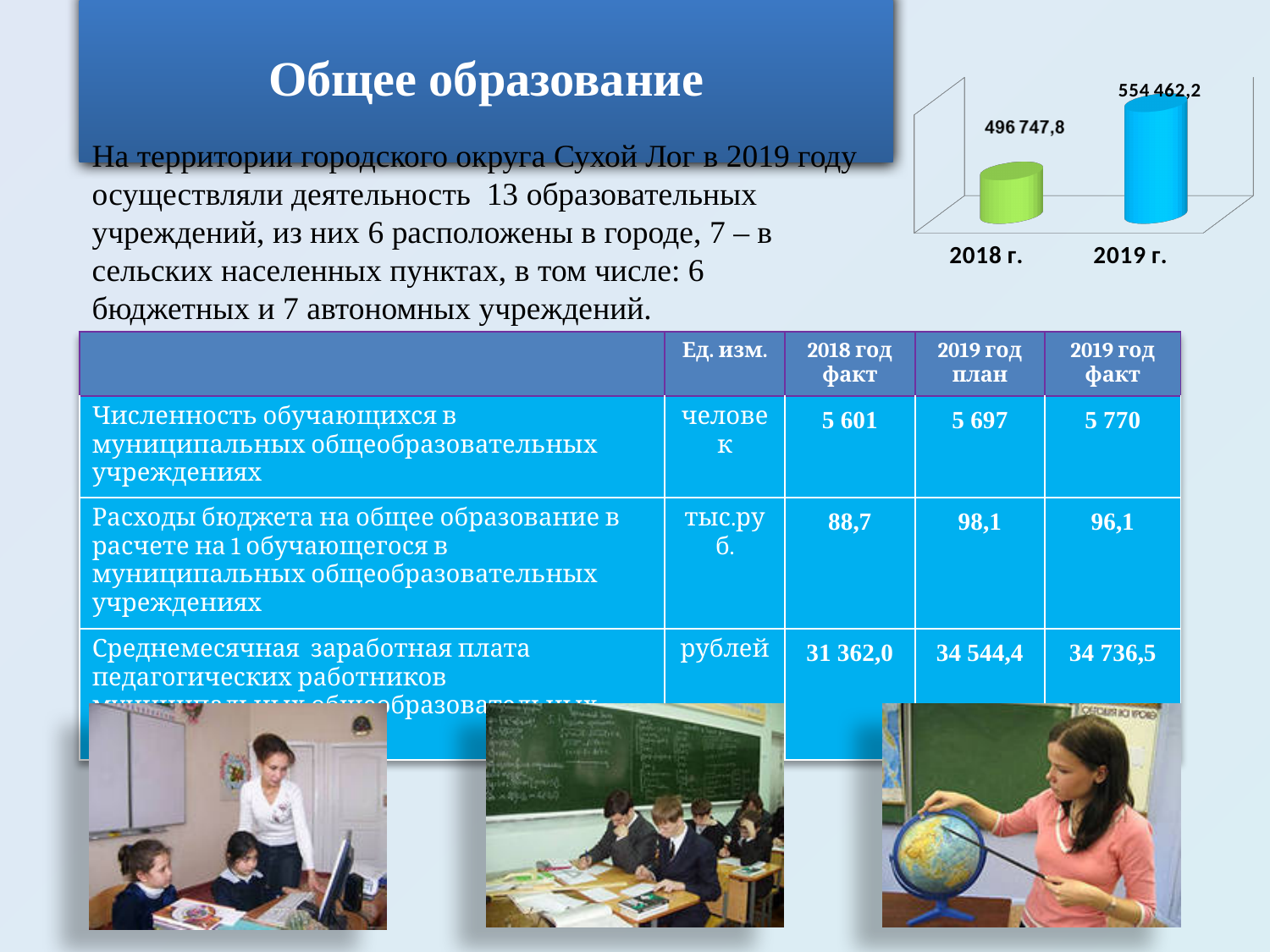
Is the value for 2019 г. larger or smaller than the value for 2018 г. in the bar chart? larger What colour is the bar for 2019 г. in the chart? blue Which year has the higher bar in the chart? 2019 г. By how much does the 2019 г. value exceed the 2018 г. value in the bar chart? 57 714,4 Do the values in the bar chart rise or fall from 2018 г. to 2019 г.? rise Which year has the lower bar in the chart? 2018 г. What is the value shown for 2018 г. in the bar chart? 496 747,8 What is the value shown for 2019 г. in the bar chart? 554 462,2 How many bars are plotted in the chart? 2 What colour is the bar for 2018 г. in the chart? green What kind of chart is shown in the top right of the slide? bar chart